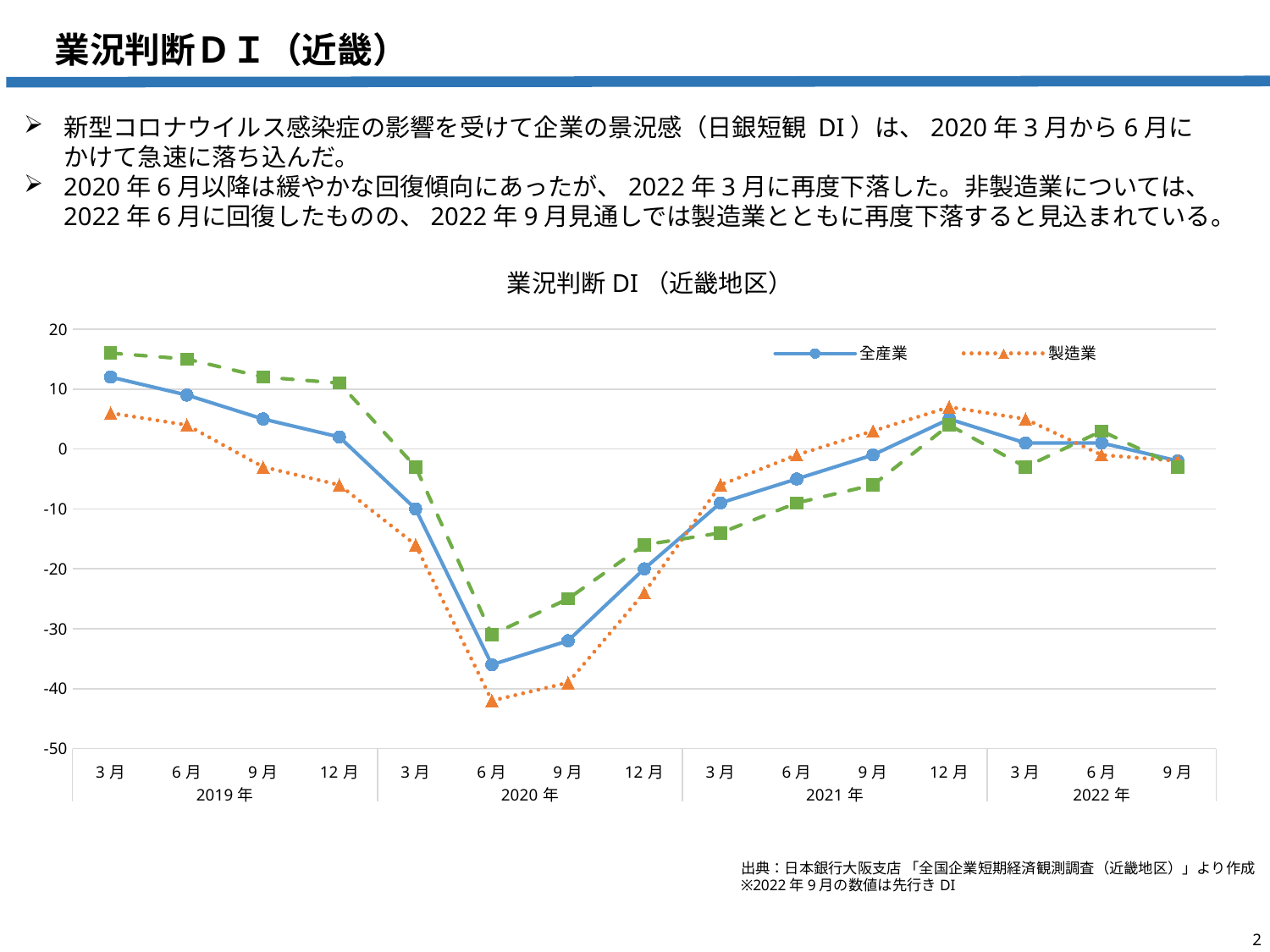
How many time points are plotted along the x axis? 15 Is the value for 製造業 in 2020年6月 greater or less than -40? less At which time point does the 製造業 series reach its lowest value? 2020年6月 Which series does the legend show with a dotted orange line and triangle markers? 製造業 Is the value for 全産業 in 2019年3月 greater or less than 10? greater How many series does the chart's legend list? 2 Is the value for 全産業 in 2020年6月 greater or less than -30? less What kind of chart is shown on the slide? line chart At which time point does the 全産業 series reach its highest value? 2019年3月 At which time point does the 全産業 series reach its lowest value? 2020年6月 What is the title of the chart? 業況判断DI（近畿地区） In 2020年6月, which series has the higher value, 全産業 or 製造業? 全産業